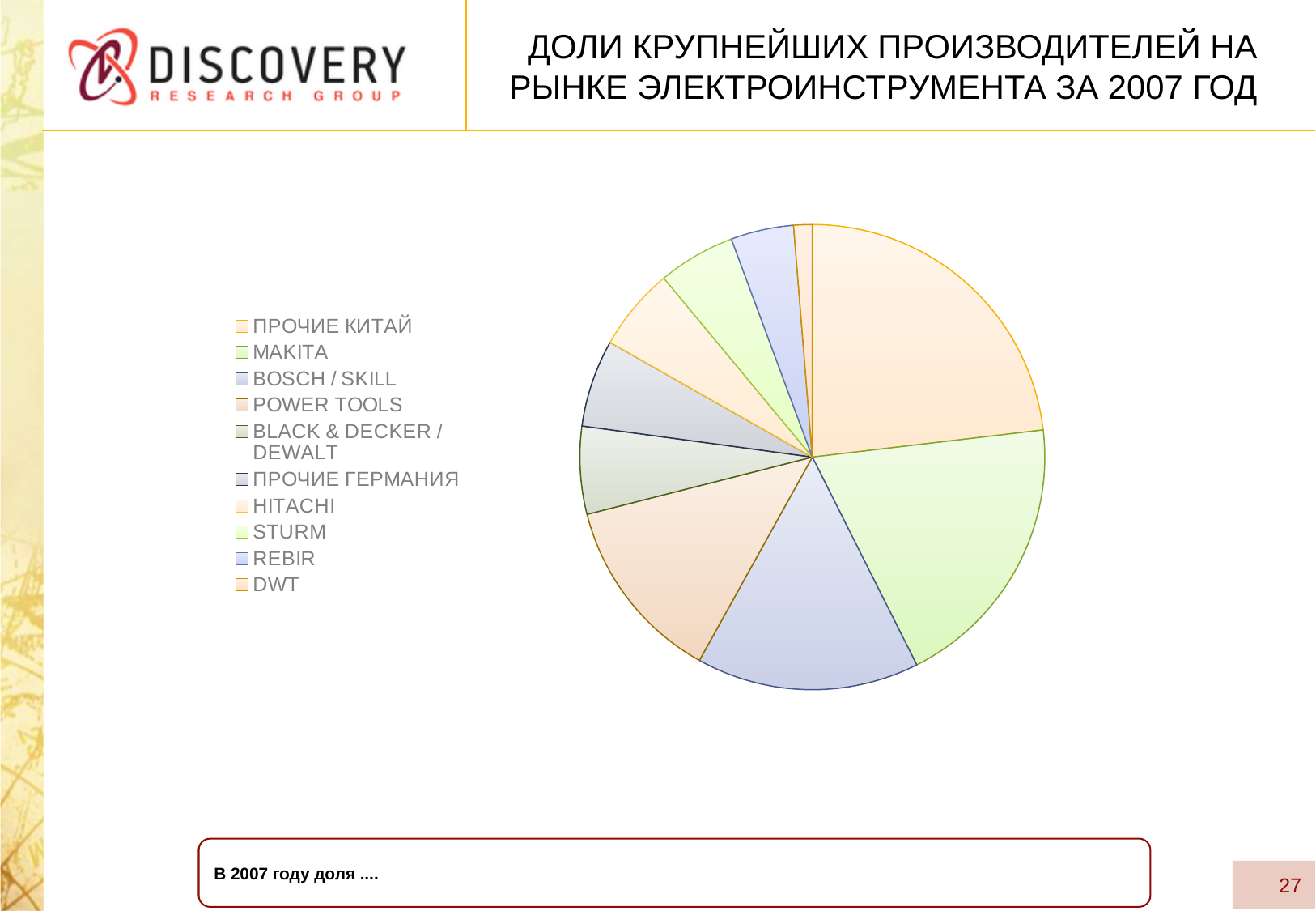
What kind of chart is shown on the slide? pie chart What is the title of the slide containing the pie chart? ДОЛИ КРУПНЕЙШИХ ПРОИЗВОДИТЕЛЕЙ НА РЫНКЕ ЭЛЕКТРОИНСТРУМЕНТА ЗА 2007 ГОД How many categories does the pie chart's legend list? 10 Which slice is larger, ПРОЧИЕ КИТАЙ or POWER TOOLS? ПРОЧИЕ КИТАЙ Which category has the largest slice of the pie? ПРОЧИЕ КИТАЙ Which category is listed first in the pie chart's legend? ПРОЧИЕ КИТАЙ Which slice is larger, MAKITA or BOSCH / SKILL? MAKITA Which slice is larger, BOSCH / SKILL or REBIR? BOSCH / SKILL Which category has the smallest slice of the pie? DWT